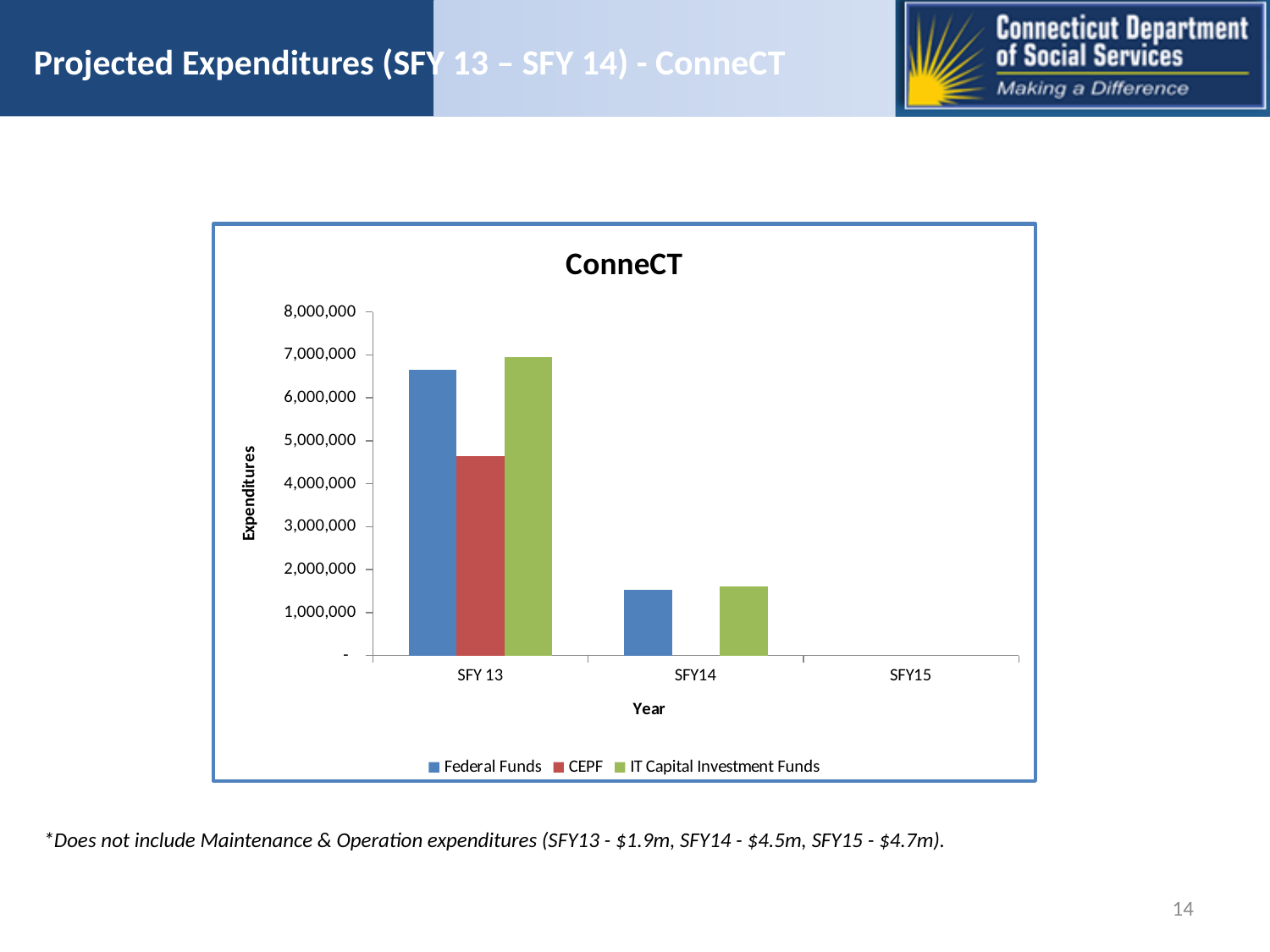
Which series has the lowest value in SFY 13? CEPF Do Federal Funds rise or fall from SFY 13 to SFY14? fall Is the value for Federal Funds in SFY 13 greater or less than 6,000,000? greater Is the value for IT Capital Investment Funds in SFY14 greater or less than 2,000,000? less How many series does the legend list? 3 In SFY 13, which is larger: Federal Funds or CEPF? Federal Funds How many year categories are shown on the x axis? 3 What type of chart is shown on the slide? bar chart Is the value for Federal Funds in SFY14 greater or less than 1,000,000? greater Which series has the highest value in SFY 13? IT Capital Investment Funds What is the label on the vertical axis of the chart? Expenditures